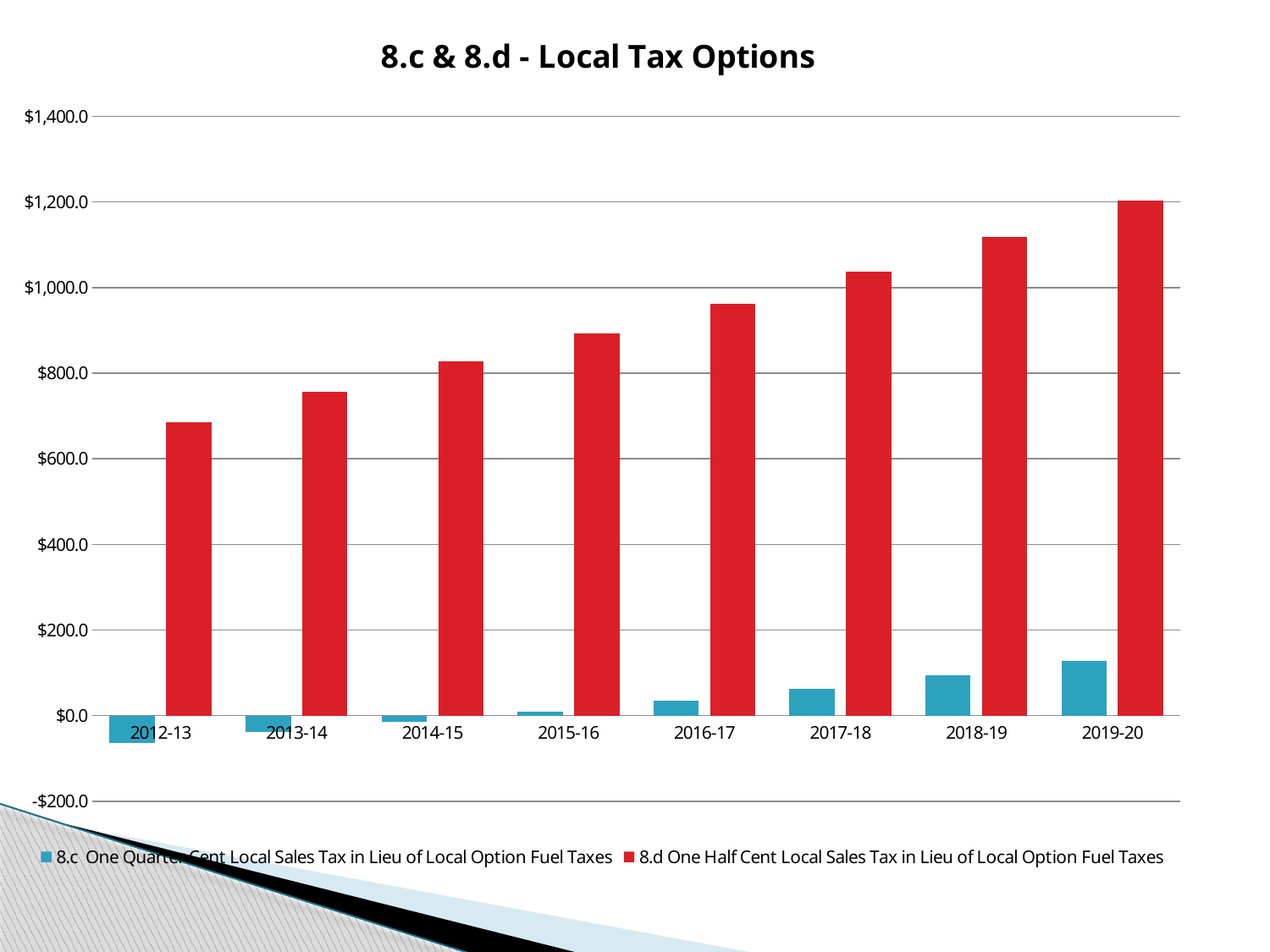
Do the values for 8.d One Half Cent Local Sales Tax rise or fall from 2012-13 to 2019-20? rise Is the value for 8.d One Half Cent Local Sales Tax in 2012-13 greater or less than $600.0? greater What kind of chart is shown on the slide? bar chart What is the title of the chart? 8.c & 8.d - Local Tax Options Which fiscal year has the lowest value for 8.c One Quarter Cent Local Sales Tax in Lieu of Local Option Fuel Taxes? 2012-13 Is the value for 8.d One Half Cent Local Sales Tax in 2015-16 greater or less than $1,000.0? less Which fiscal year has the highest value for 8.d One Half Cent Local Sales Tax in Lieu of Local Option Fuel Taxes? 2019-20 How many fiscal years are shown on the x axis? 8 Is the value for 8.c One Quarter Cent Local Sales Tax in 2012-13 greater or less than $0.0? less How many series does the legend list? 2 Which fiscal year has the lowest value for 8.d One Half Cent Local Sales Tax in Lieu of Local Option Fuel Taxes? 2012-13